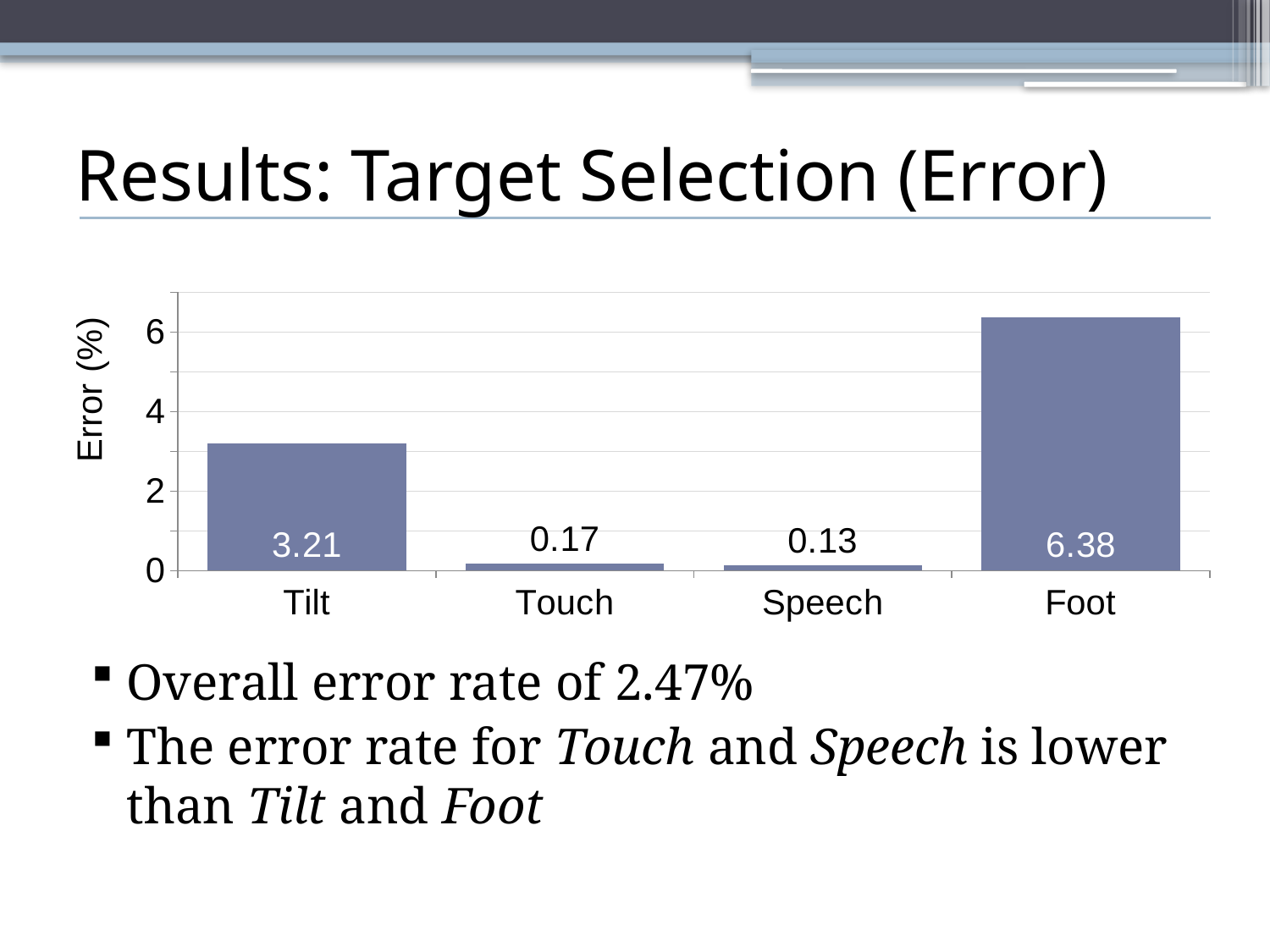
Is the value for Foot greater or less than 6? greater Which category has the highest error? Foot Which category has the lowest error? Speech What is the error value for Touch? 0.17 What is the error value for Speech? 0.13 What is the error value for Tilt? 3.21 What is the error value for Foot? 6.38 What is the difference in error between Touch and Speech? 0.04 What is the difference in error between Foot and Tilt? 3.17 Which has a larger error, Tilt or Foot? Foot How many categories are shown on the x axis? 4 What kind of chart is shown on the slide? bar chart